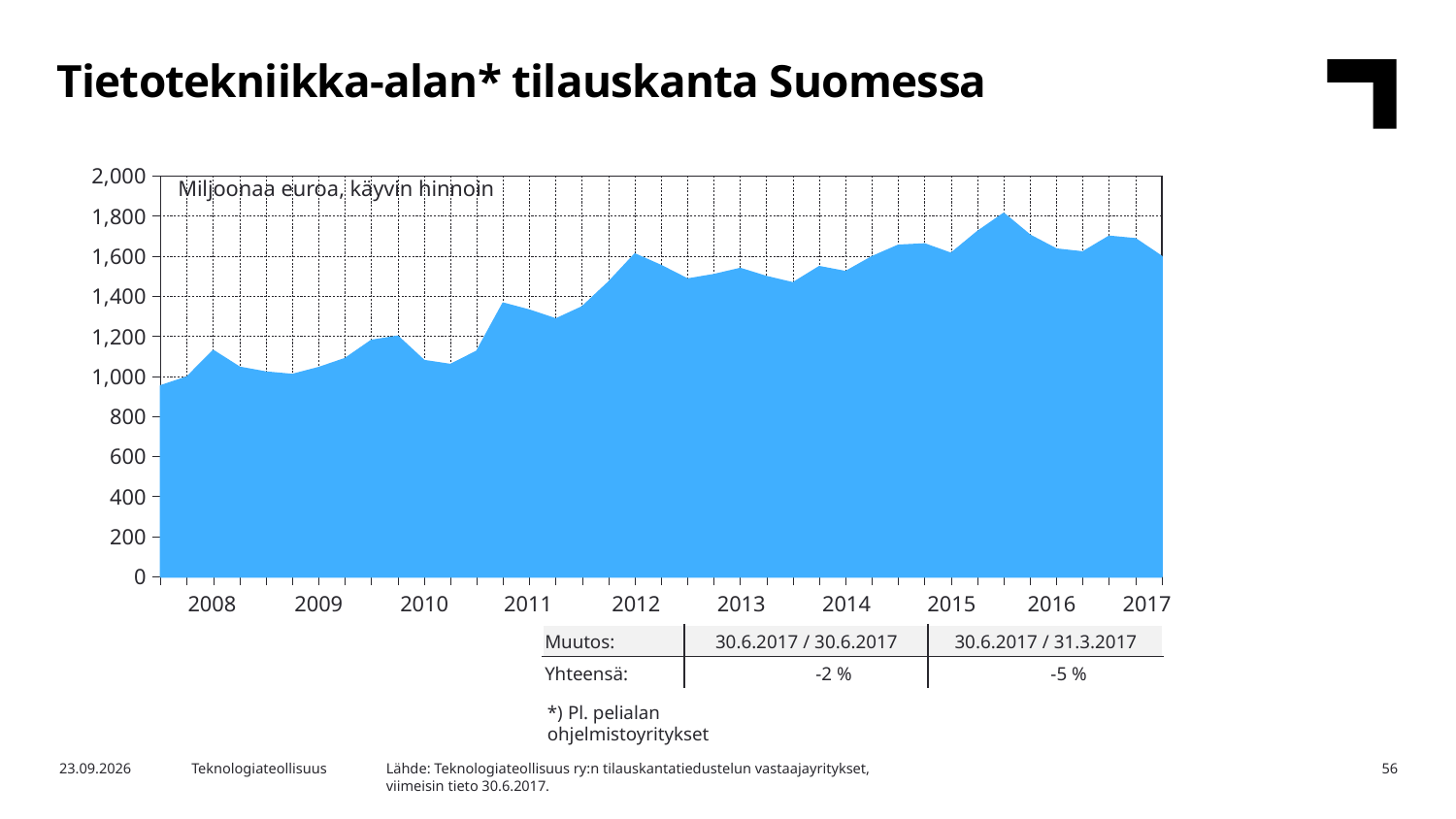
Is the peak value of the series, reached between 2015 and 2016, greater or less than 1,600? greater Is the value at the start of 2013 greater or less than 1,000? greater Is the value at the start of 2012 greater or less than 1,400? greater How many year labels are shown on the x axis? 10 Is the lowest value of the series at the beginning (2008) or at the end (2017) of the period? beginning (2008) Overall, does the order backlog rise or fall from 2008 to 2017? rise What is the highest value shown on the y axis? 2,000 What is the title of the chart on the slide? Tietotekniikka-alan* tilauskanta Suomessa According to the table below the chart, what is the change (Muutos) for 30.6.2017 / 31.3.2017? -5 % What unit is stated inside the chart area? Miljoonaa euroa, käyvin hinnoin What kind of chart is shown on the slide? Area chart